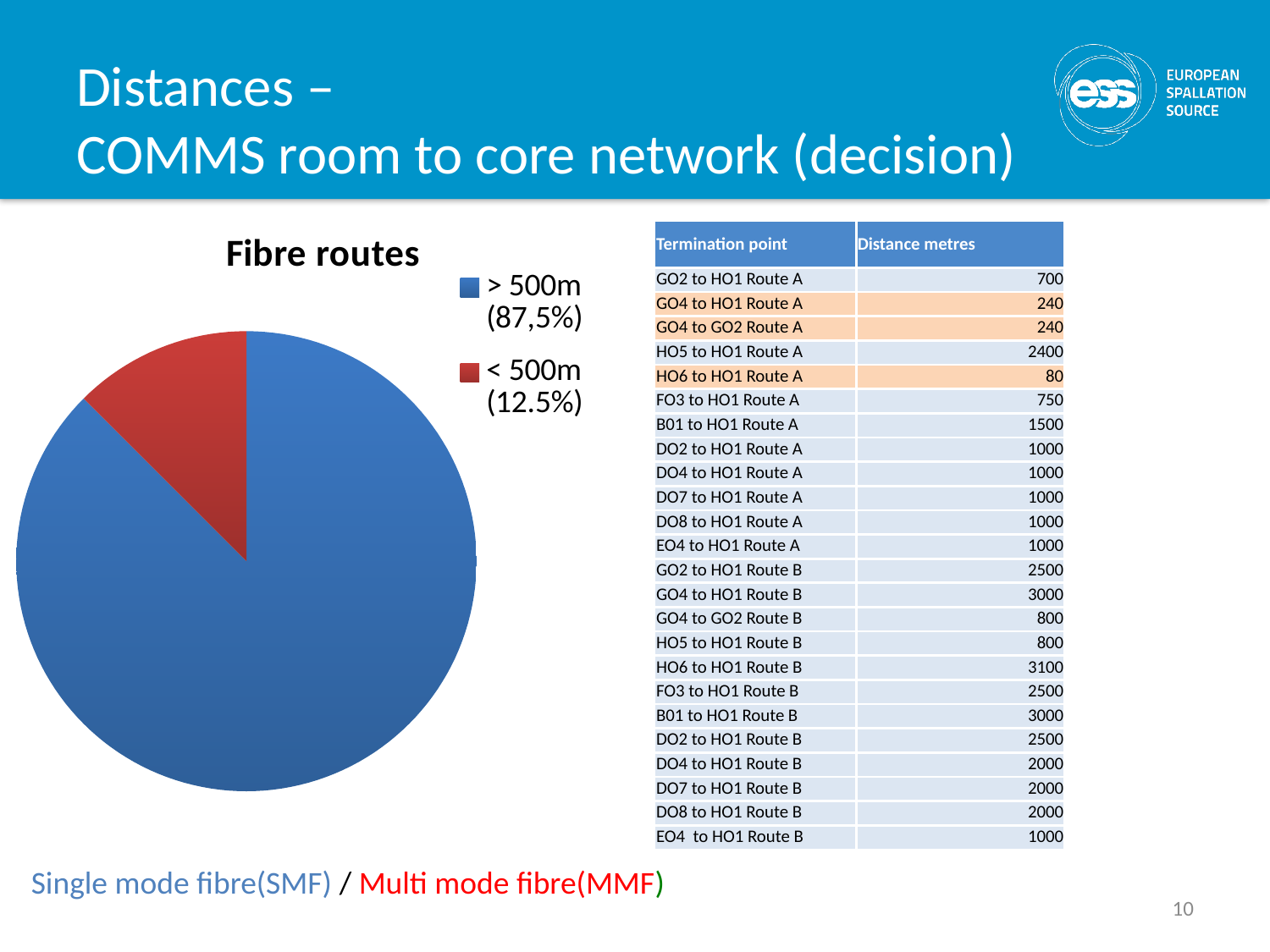
In the "Fibre routes" pie chart, which is larger: the "> 500m" slice or the "< 500m" slice? > 500m What share of the "Fibre routes" pie is taken by the "< 500m" slice? 12.5% Which slice of the "Fibre routes" pie chart is the largest? > 500m How many slices does the "Fibre routes" pie chart have? 2 What colour is the "< 500m" slice in the "Fibre routes" pie chart? red How many entries does the legend of the "Fibre routes" pie chart list? 2 What is the title of the pie chart on the slide? Fibre routes What kind of chart is the "Fibre routes" chart? pie chart What share of the "Fibre routes" pie is taken by the "> 500m" slice? 87,5% Which slice of the "Fibre routes" pie chart is the smallest? < 500m